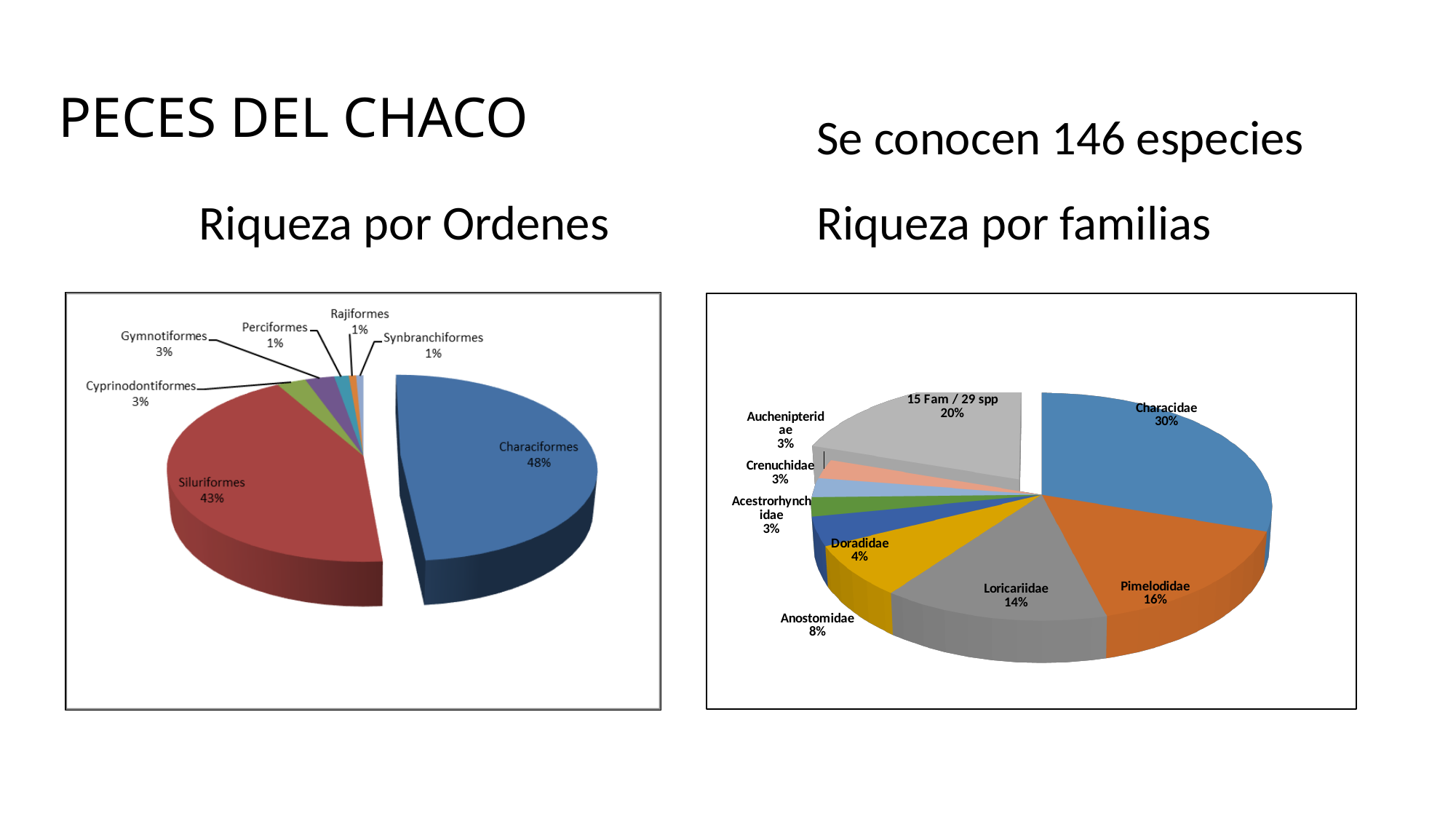
In the 'Riqueza por familias' chart, what share does Characidae have? 30% What kind of chart is the 'Riqueza por Ordenes' chart? Pie chart In the 'Riqueza por familias' chart, which is larger, Pimelodidae or Anostomidae? Pimelodidae In the 'Riqueza por familias' chart, what share does Loricariidae have? 14% In the 'Riqueza por familias' chart, which family has the largest share? Characidae In the 'Riqueza por familias' chart, how many slices are shown? 9 In the 'Riqueza por Ordenes' chart, what share does Siluriformes have? 43% In the 'Riqueza por Ordenes' chart, how many orders are shown? 7 In the 'Riqueza por Ordenes' chart, which order has the largest share? Characiformes In the 'Riqueza por familias' chart, what is the difference in percentage points between Characidae and Pimelodidae? 14 In the 'Riqueza por Ordenes' chart, what is the difference in percentage points between Characiformes and Siluriformes? 5 In the 'Riqueza por Ordenes' chart, what share does Characiformes have? 48%